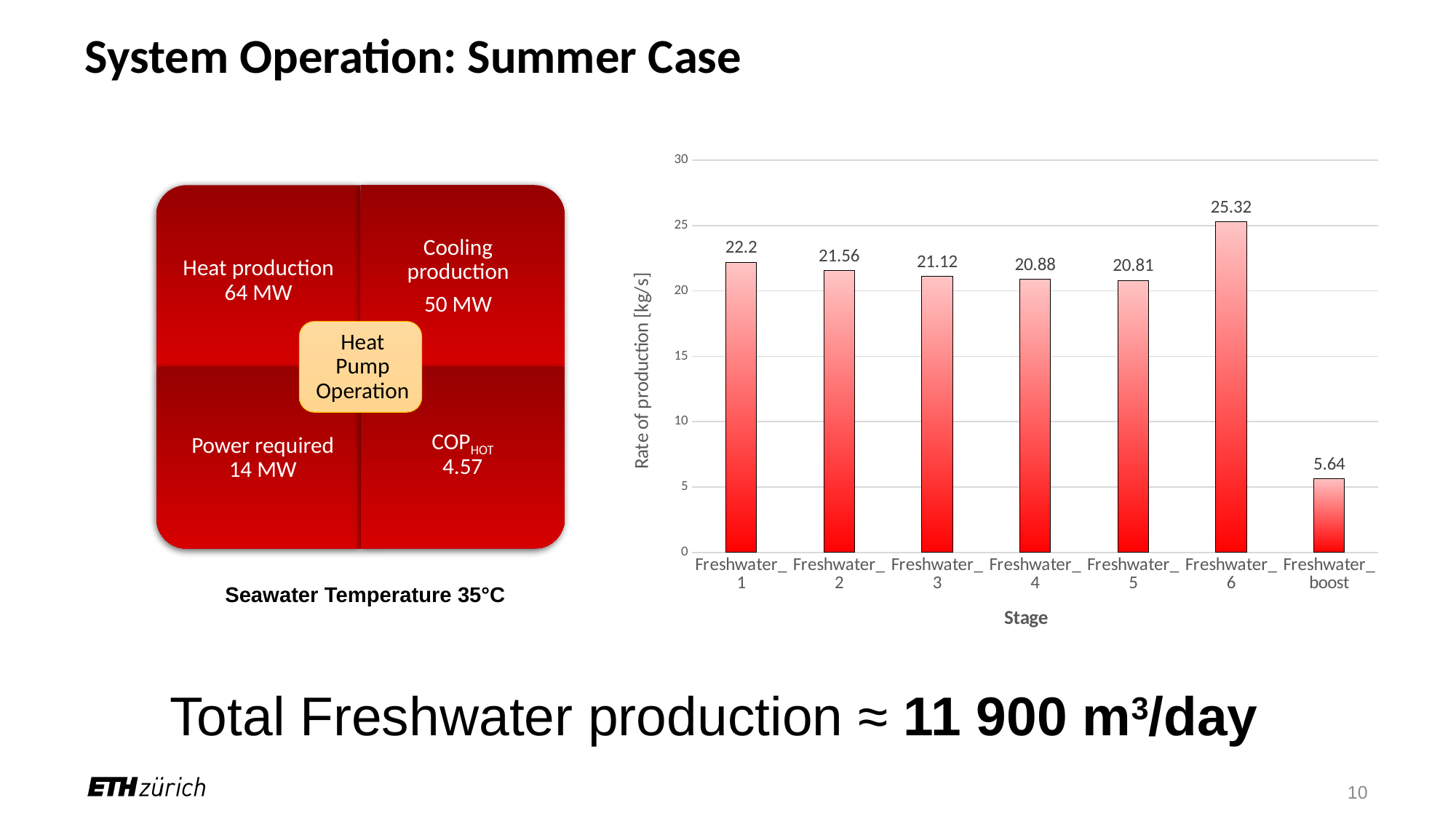
What is the difference in rate of production between Freshwater_1 and Freshwater_2? 0.64 Which stage has the highest rate of production? Freshwater_6 What is the rate of production for Freshwater_4? 20.88 Which stage has the lowest rate of production? Freshwater_boost Which has a higher rate of production, Freshwater_3 or Freshwater_6? Freshwater_6 What is the rate of production for Freshwater_1? 22.2 What is the difference in rate of production between Freshwater_6 and Freshwater_boost? 19.68 What is the label of the y axis of the chart? Rate of production [kg/s] Is the value for Freshwater_5 greater or less than 15? greater How many stages are shown on the x axis of the chart? 7 What kind of chart is used to show the rate of production by stage? bar chart What is the rate of production for Freshwater_boost? 5.64